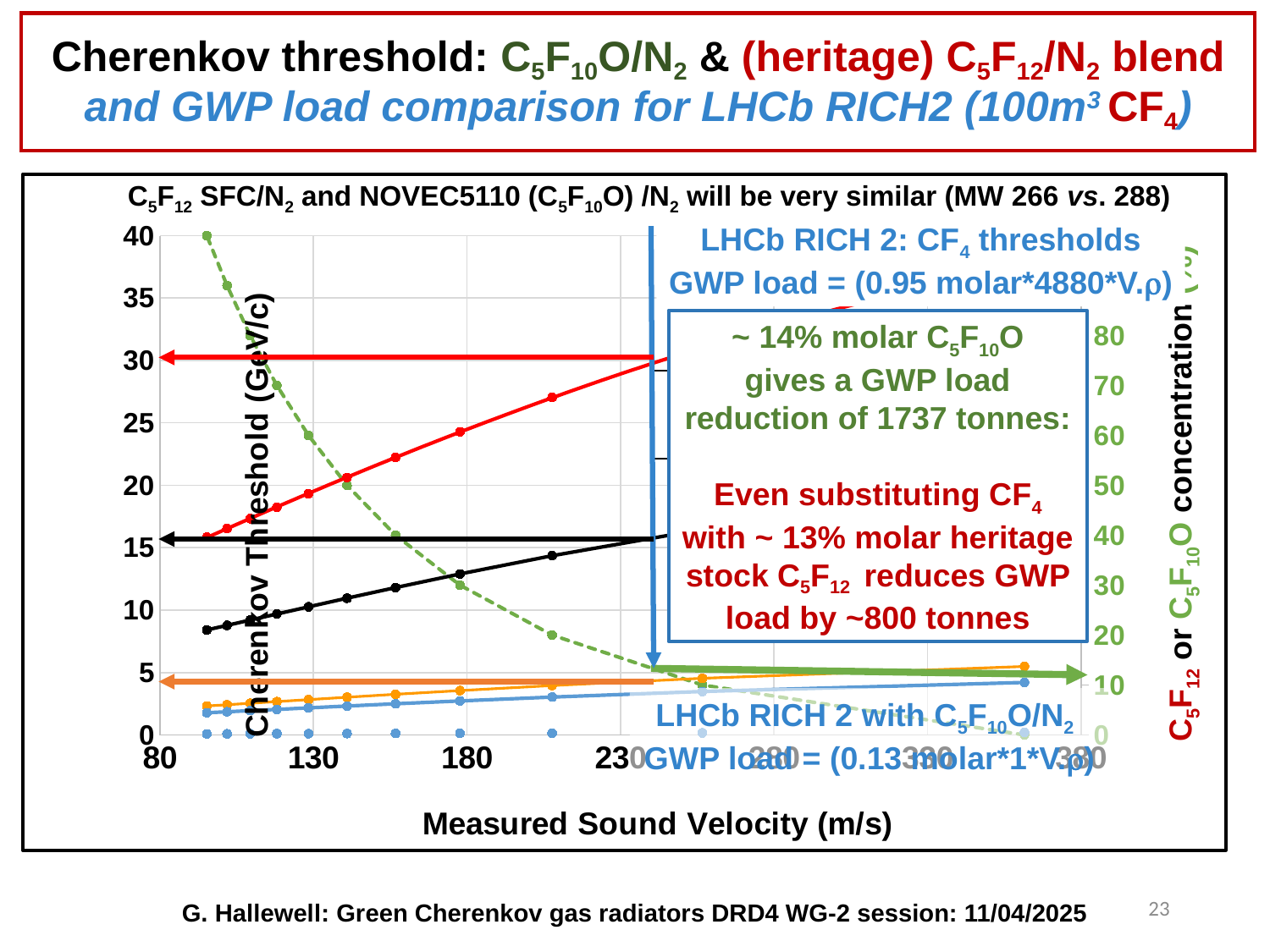
Is the Cherenkov threshold on the red solid line at a sound velocity of 180 m/s greater or less than 20 GeV/c? greater What kind of chart is shown on the slide? line chart Does the green dashed line rise or fall as the measured sound velocity increases? fall At a sound velocity of 180 m/s, which line shows the higher Cherenkov threshold, the red solid line or the black solid line? red solid line What is the title of the x axis of the chart? Measured Sound Velocity (m/s) What is the highest value shown on the left y axis of the chart? 40 Does the black solid line rise or fall as the measured sound velocity increases? rise What is the title of the left y axis of the chart? Cherenkov Threshold (GeV/c) Is the Cherenkov threshold on the black solid line at a sound velocity of 130 m/s greater or less than 15 GeV/c? less Is the Cherenkov threshold on the black solid line at a sound velocity of 180 m/s greater or less than 15 GeV/c? less Does the red solid line rise or fall as the measured sound velocity increases? rise